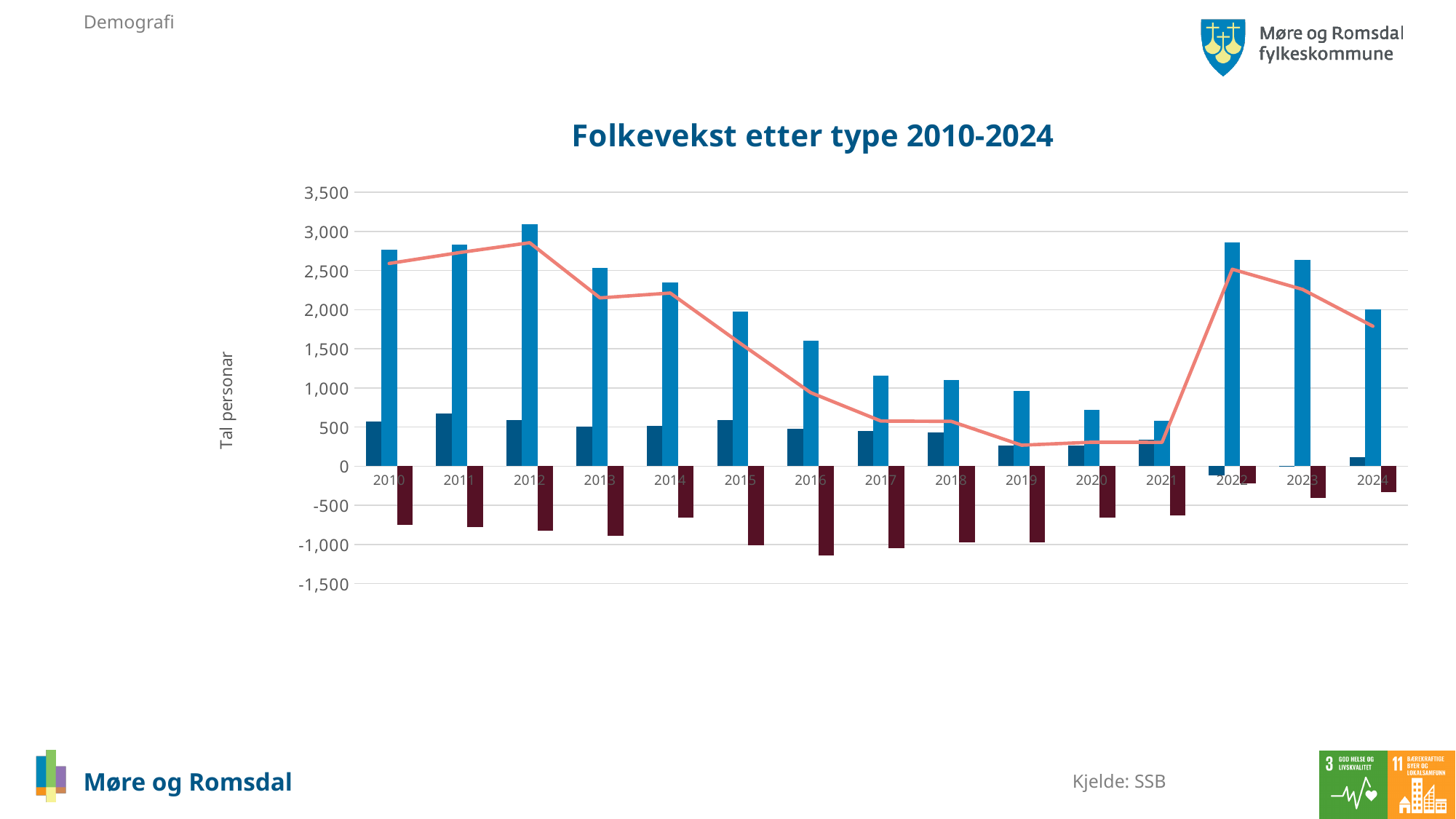
What kind of chart is this? bar chart with a line What is the label on the vertical axis of the chart? Tal personar Is the value of the light blue bar for 2012 greater or less than 3,000? greater Which year has the taller light blue bar, 2022 or 2023? 2022 In which year does the dark red bar reach the lowest (most negative) value? 2016 Is the value of the dark red bar for 2016 greater or less than -1,000? less Do the light blue bars rise or fall from 2012 to 2020? fall In which year does the salmon-coloured line reach its highest point? 2012 In which year is the light blue bar the shortest? 2021 How many years are shown along the x axis of the chart? 15 What is the title of the chart? Folkevekst etter type 2010-2024 In which year is the light blue bar the tallest? 2012